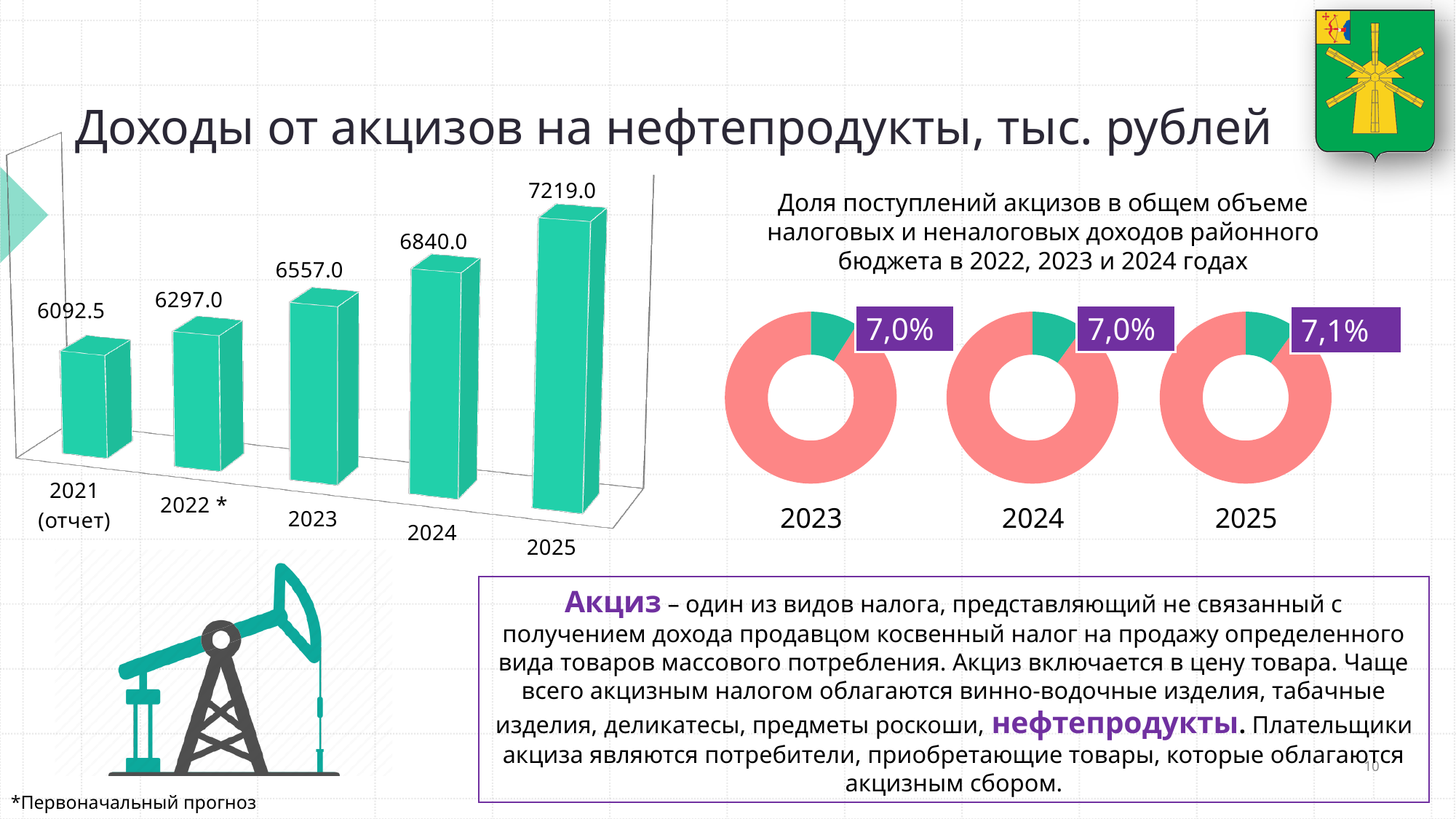
In the bar chart on the left, which year has the lowest value? 2021 (отчет) In the bar chart on the left, what is the value for 2021 (отчет)? 6092.5 How many bars are in the bar chart on the left? 5 In the bar chart on the left, what is the value for 2025? 7219.0 In the bar chart on the left, what is the difference between the values for 2025 and 2024? 379.0 In the bar chart on the left, which is larger: the value for 2023 or the value for 2024? 2024 In the bar chart on the left, which year has the highest value? 2025 In the bar chart on the left, what is the difference between the values for 2022 * and 2021 (отчет)? 204.5 Do the values in the bar chart on the left rise or fall from 2021 to 2025? rise What type of chart is used on the left side of the slide? bar chart In the bar chart on the left, what is the value for 2023? 6557.0 In the donut charts on the right, what share is shown for 2025? 7,1%